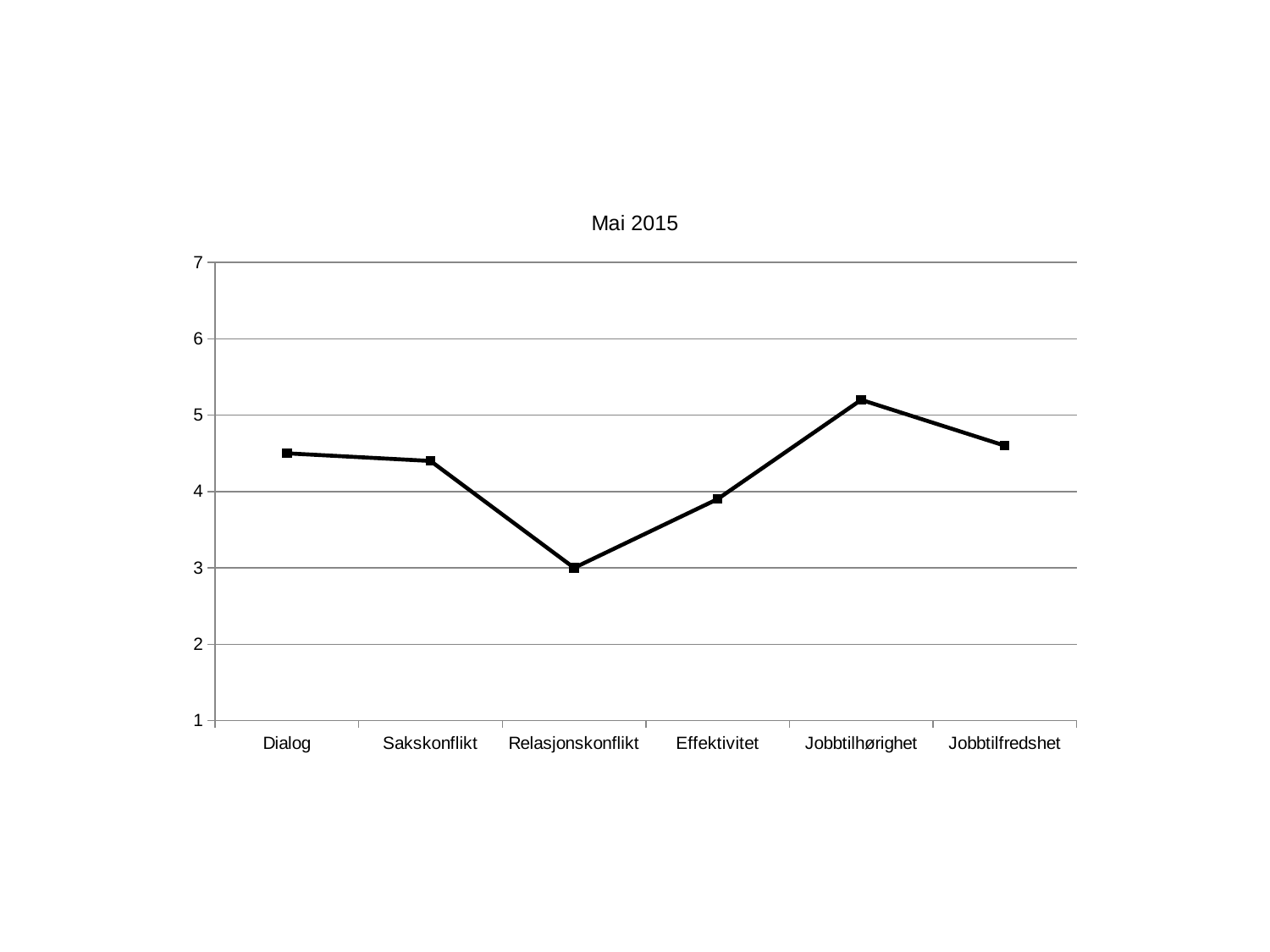
Which is larger, the value for Jobbtilhørighet or the value for Jobbtilfredshet? Jobbtilhørighet Is the value for Jobbtilhørighet greater or less than 5? greater Which category has the lowest value? Relasjonskonflikt What is the value for Relasjonskonflikt? 3 How many categories are plotted along the x axis? 6 Which category has the highest value? Jobbtilhørighet Do the values rise or fall from Relasjonskonflikt to Jobbtilhørighet? rise What is the title of the chart? Mai 2015 Is the value for Jobbtilfredshet greater or less than 5? less What type of chart is shown on the slide? line chart Is the value for Dialog greater or less than 4? greater